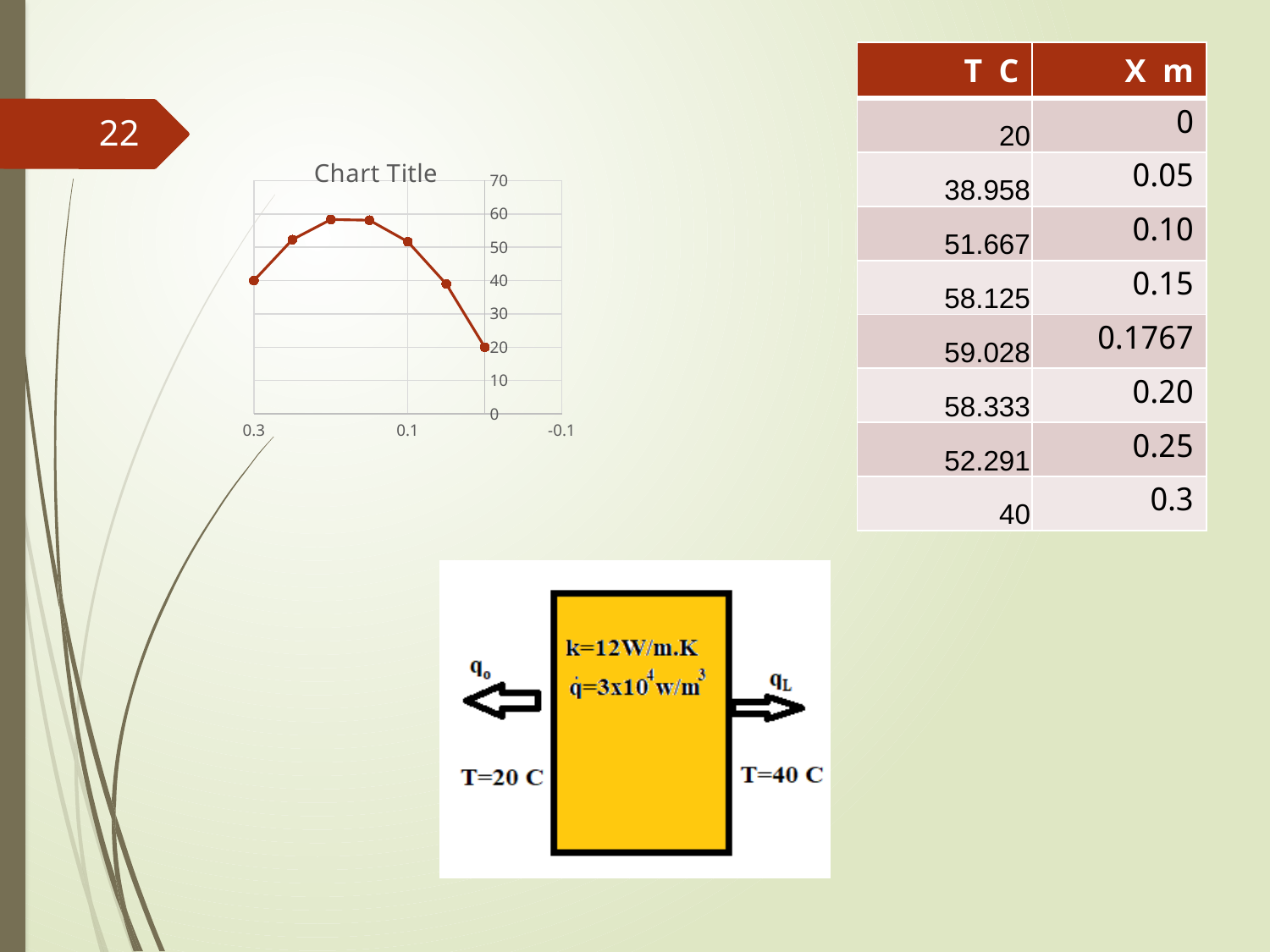
Which is larger: the value at x = 0.3 or the value at x = 0? x = 0.3 Moving from left to right along the x axis, do the plotted values rise steadily, fall steadily, or rise and then fall? rise and then fall Is the value of the point at x = 0.25 greater or less than 50? greater How many data points are plotted on the line? 7 What is the value of the point at x = 0 on the chart? 20 What is the title of the chart? Chart Title What kind of chart is shown on the slide? line chart What is the highest value shown on the chart's vertical axis? 70 Which point on the chart has the lowest value? x = 0 Is the value of the point at x = 0.3 greater or less than 30? greater Is the value of the point at x = 0.05 greater or less than 50? less What is the value of the point at x = 0.3 on the chart? 40